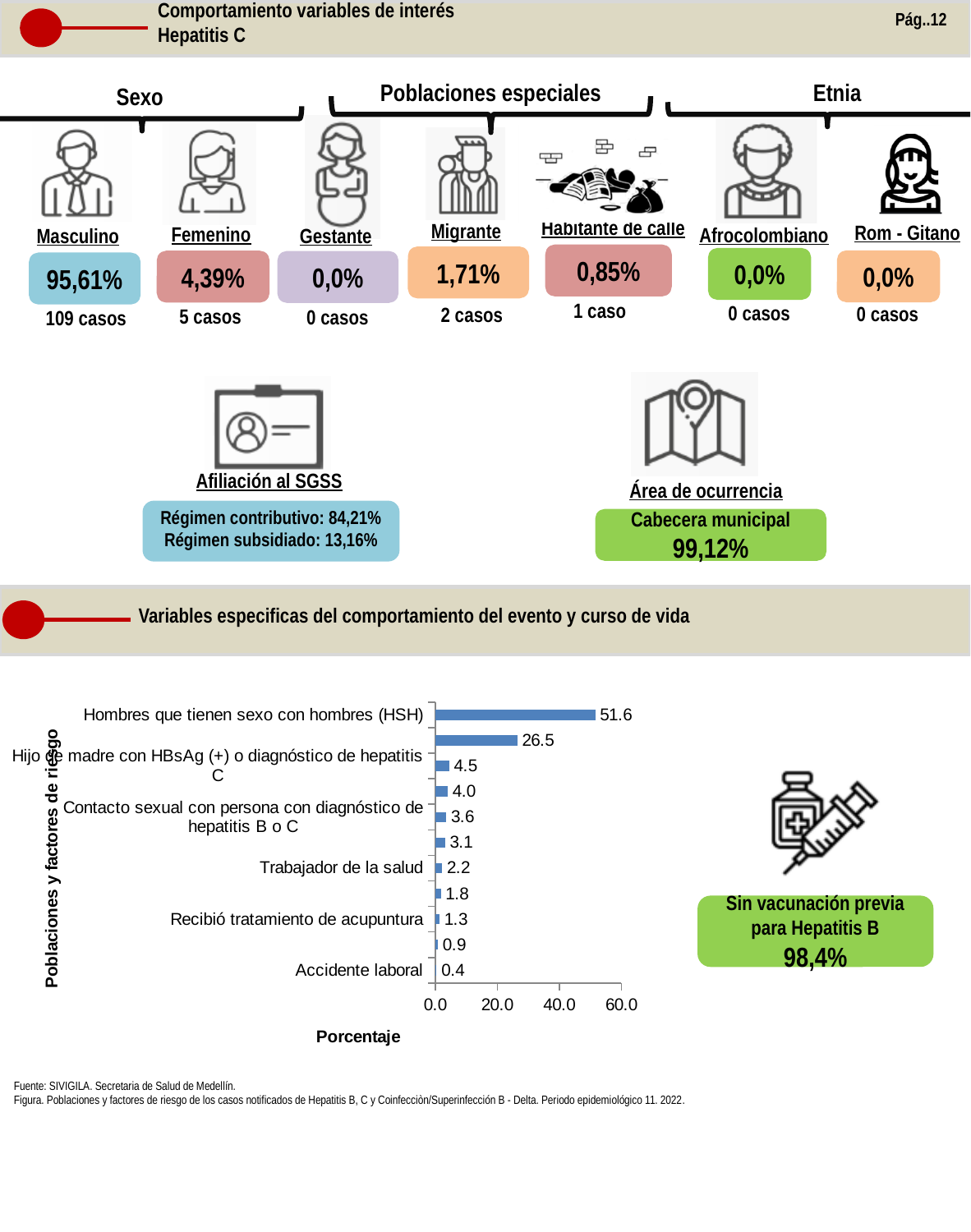
What is the value for 'Accidente laboral' in the bar chart? 0.4 Which category has the lowest value in the bar chart? Accidente laboral How many bars are plotted in the bar chart? 11 What is the value for 'Trabajador de la salud' in the bar chart? 2.2 What is the difference between the values for 'Hombres que tienen sexo con hombres (HSH)' and 'Trabajador de la salud' in the bar chart? 49.4 What is the value for 'Contacto sexual con persona con diagnóstico de hepatitis B o C' in the bar chart? 3.6 What is the value for 'Hombres que tienen sexo con hombres (HSH)' in the bar chart? 51.6 Which category has the highest value in the bar chart? Hombres que tienen sexo con hombres (HSH) What type of chart is shown at the bottom of the slide? bar chart What is the label of the horizontal axis of the bar chart? Porcentaje What is the value for 'Recibió tratamiento de acupuntura' in the bar chart? 1.3 Which is larger in the bar chart: the value for 'Trabajador de la salud' or for 'Recibió tratamiento de acupuntura'? Trabajador de la salud